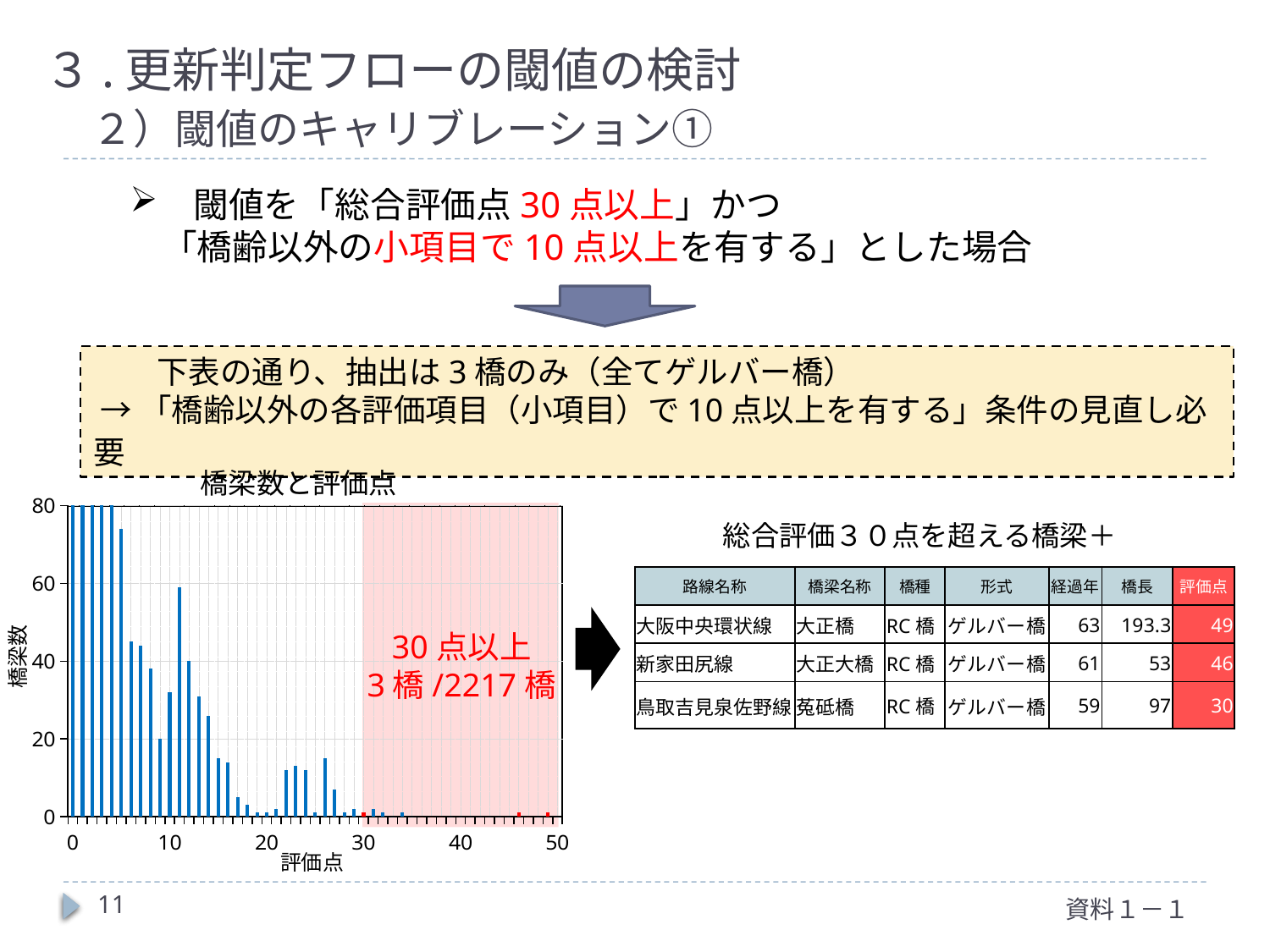
In the chart, is the value for 評価点 20 greater or less than 20? less According to the annotation in the shaded area of the chart, how many bridges have a score of 30 or more? 3橋/2217橋 What kind of chart is shown on the slide? bar chart In the chart, is the value for 評価点 11 greater or less than 40? greater In the chart, do the values rise or fall as 評価点 goes from 11 to 17? fall In the chart, is the value for 評価点 5 greater or less than 60? greater In the chart, which is larger, the value for 評価点 11 or the value for 評価点 13? 評価点 11 In the chart, which is larger, the value for 評価点 7 or the value for 評価点 17? 評価点 7 What is the label of the x axis of the chart? 評価点 What is the title of the chart on the slide? 橋梁数と評価点